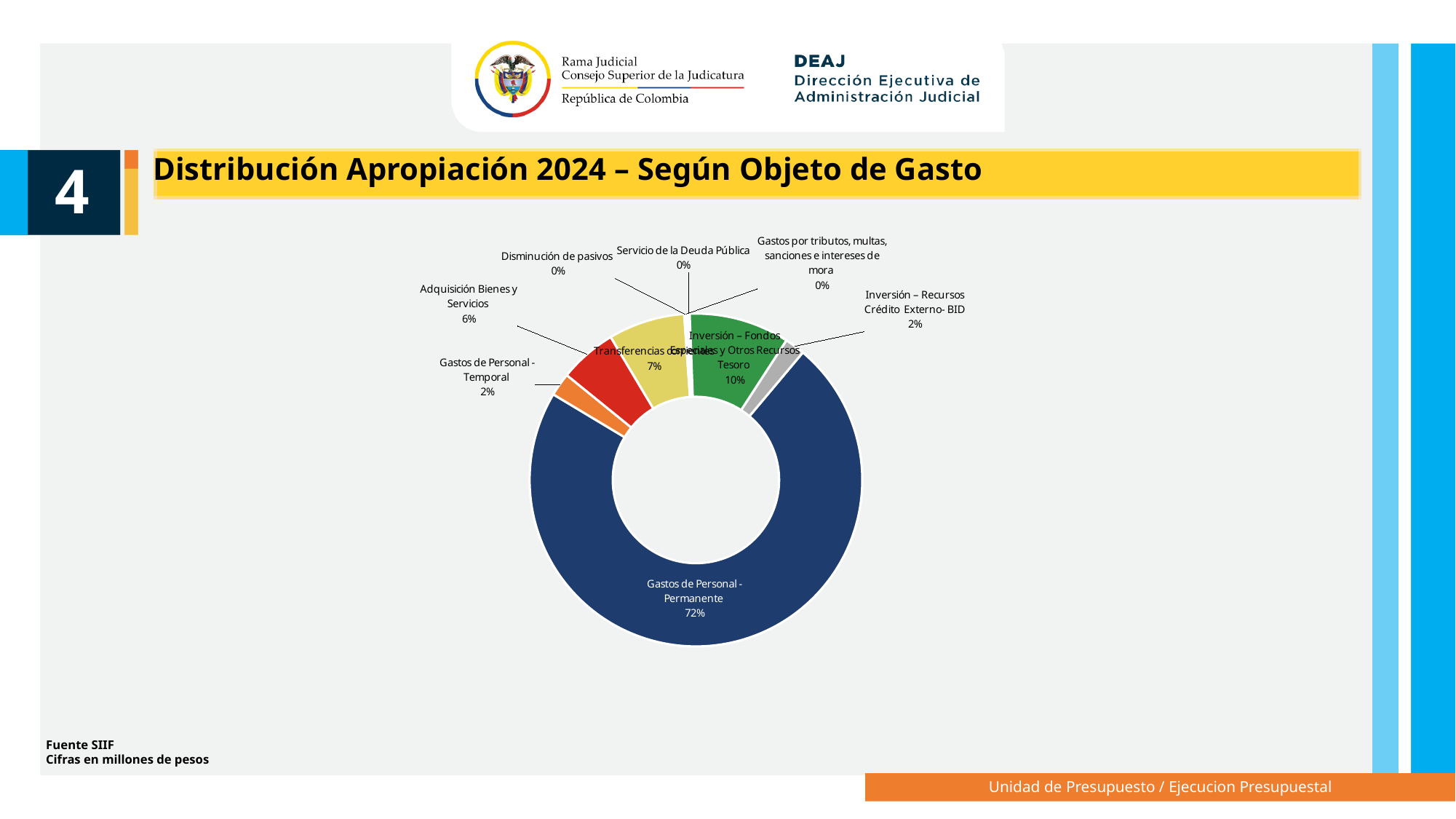
What percentage is shown for Adquisición Bienes y Servicios? 6% Which is larger, the share for Adquisición Bienes y Servicios or the share for Inversión – Fondos Especiales y Otros Recursos Tesoro? Inversión – Fondos Especiales y Otros Recursos Tesoro How many categories are labelled with 0%? 3 What is the difference in percentage points between Gastos de Personal - Permanente and Inversión – Fondos Especiales y Otros Recursos Tesoro? 62 percentage points What percentage is shown for Inversión – Recursos Crédito Externo- BID? 2% What percentage is shown for Gastos de Personal - Temporal? 2% What share of the 2024 appropriation goes to Gastos de Personal - Permanente? 72% What percentage is shown for Inversión – Fondos Especiales y Otros Recursos Tesoro? 10% How many categories are shown in the chart? 9 What kind of chart is shown on the slide? Doughnut (pie) chart Which category has the largest share of the appropriation? Gastos de Personal - Permanente What is the title of the slide containing the chart? Distribución Apropiación 2024 – Según Objeto de Gasto